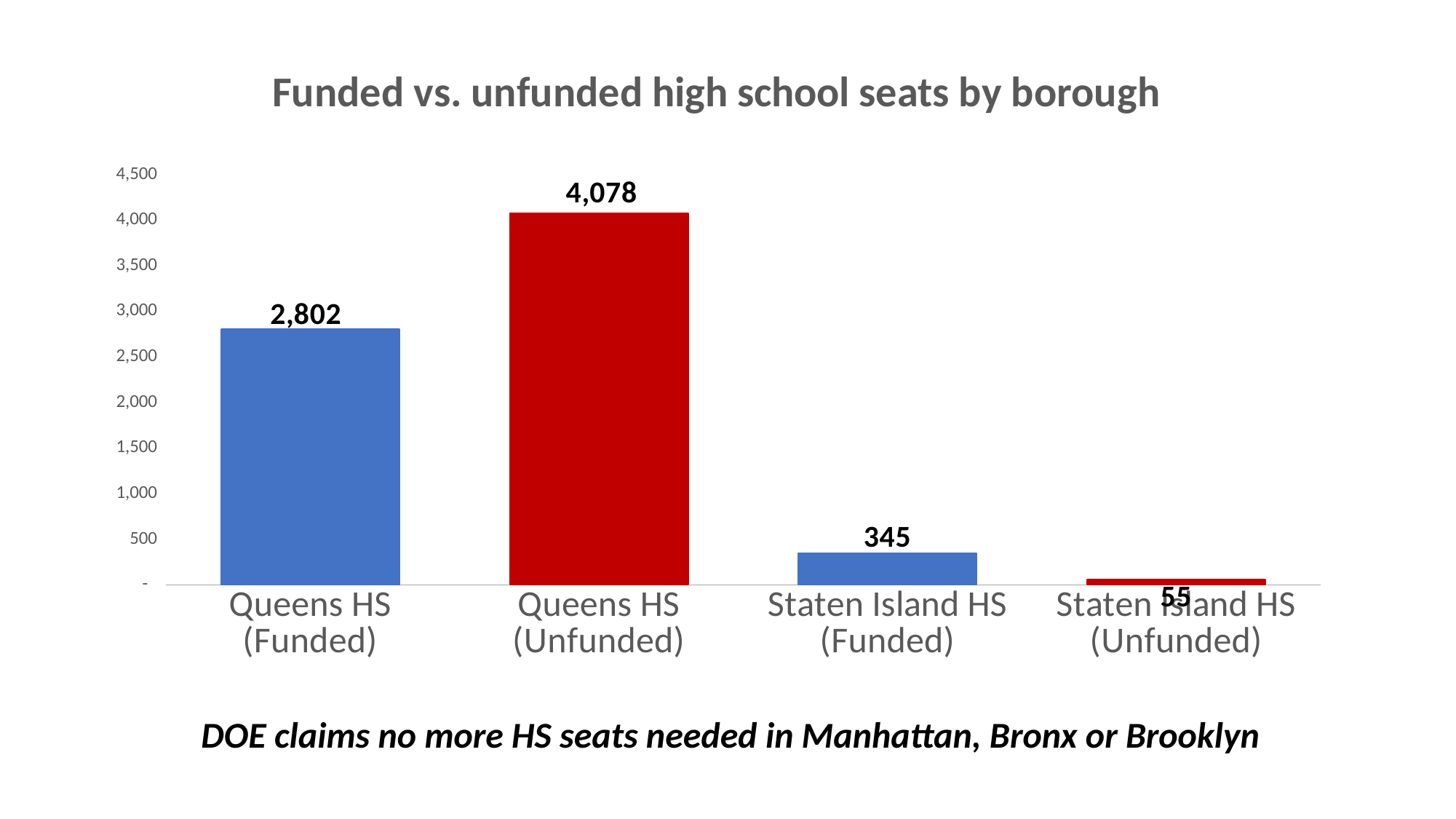
What is the value for Staten Island HS (Funded)? 345 What is the value for Queens HS (Funded)? 2,802 Which category has the highest value? Queens HS (Unfunded) How many categories are shown on the chart? 4 Which category has the lowest value? Staten Island HS (Unfunded) What is the value for Queens HS (Unfunded)? 4,078 Which is larger, Queens HS (Funded) or Staten Island HS (Funded)? Queens HS (Funded) What is the difference between Staten Island HS (Funded) and Staten Island HS (Unfunded)? 290 Is the value for Queens HS (Funded) greater or less than 3,000? less What kind of chart is shown on the slide? Bar chart What is the value for Staten Island HS (Unfunded)? 55 What is the difference between Queens HS (Unfunded) and Queens HS (Funded)? 1,276